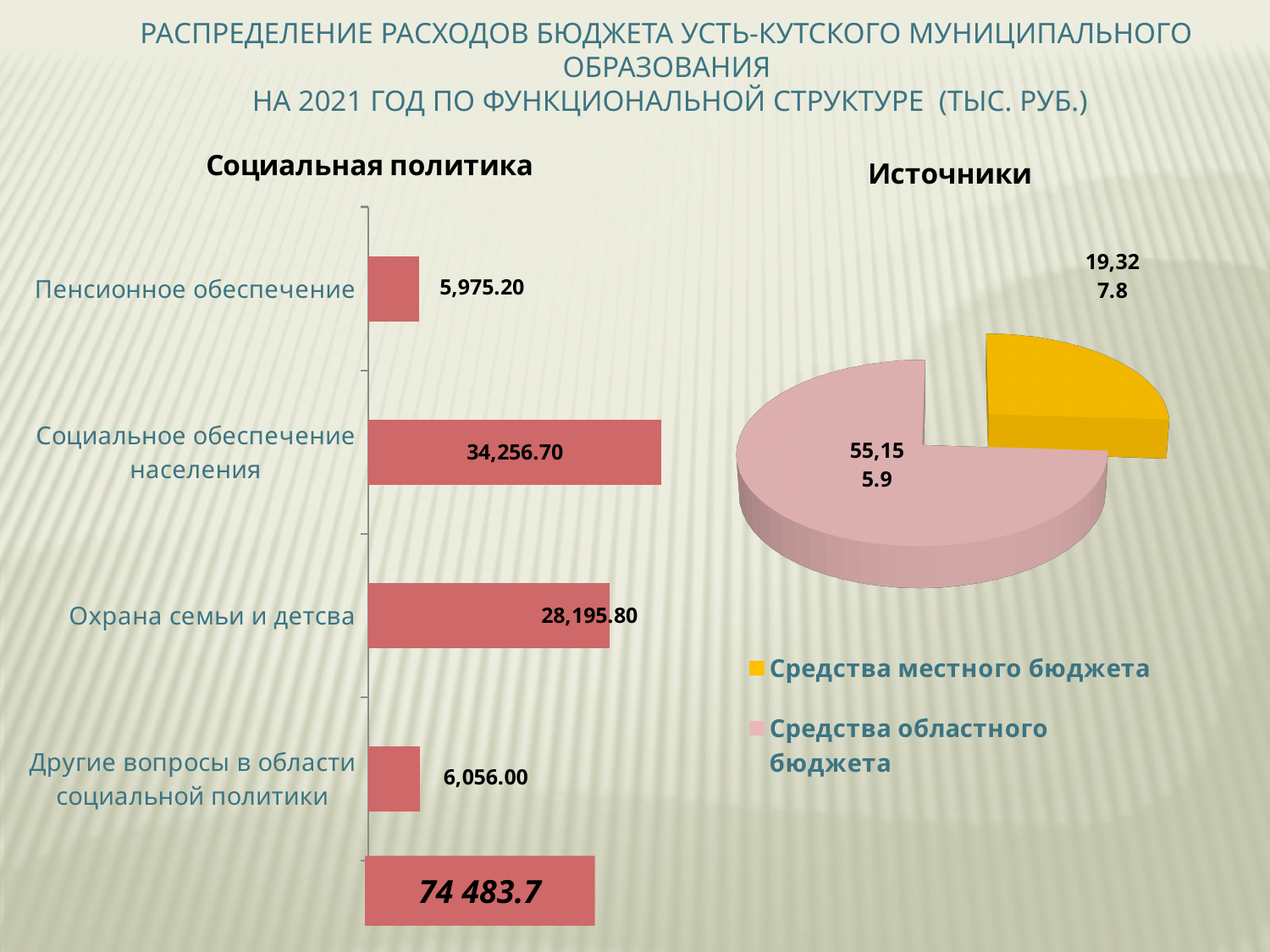
What kind of chart is the 'Социальная политика' chart? Bar chart In the 'Социальная политика' bar chart, which is larger: 'Другие вопросы в области социальной политики' or 'Пенсионное обеспечение'? Другие вопросы в области социальной политики In the 'Источники' pie chart, which slice is larger: 'Средства местного бюджета' or 'Средства областного бюджета'? Средства областного бюджета How many categories are shown in the 'Социальная политика' bar chart? 4 In the 'Социальная политика' bar chart, what is the value for 'Пенсионное обеспечение'? 5,975.20 In the 'Социальная политика' bar chart, what is the difference between 'Социальное обеспечение населения' and 'Охрана семьи и детства'? 6,060.90 In the 'Социальная политика' bar chart, which category has the highest value? Социальное обеспечение населения In the 'Социальная политика' bar chart, what is the value for 'Другие вопросы в области социальной политики'? 6,056.00 In the 'Социальная политика' bar chart, what is the value for 'Охрана семьи и детства'? 28,195.80 How many entries does the legend of the 'Источники' pie chart list? 2 In the 'Социальная политика' bar chart, which category has the lowest value? Пенсионное обеспечение In the 'Социальная политика' bar chart, what is the value for 'Социальное обеспечение населения'? 34,256.70